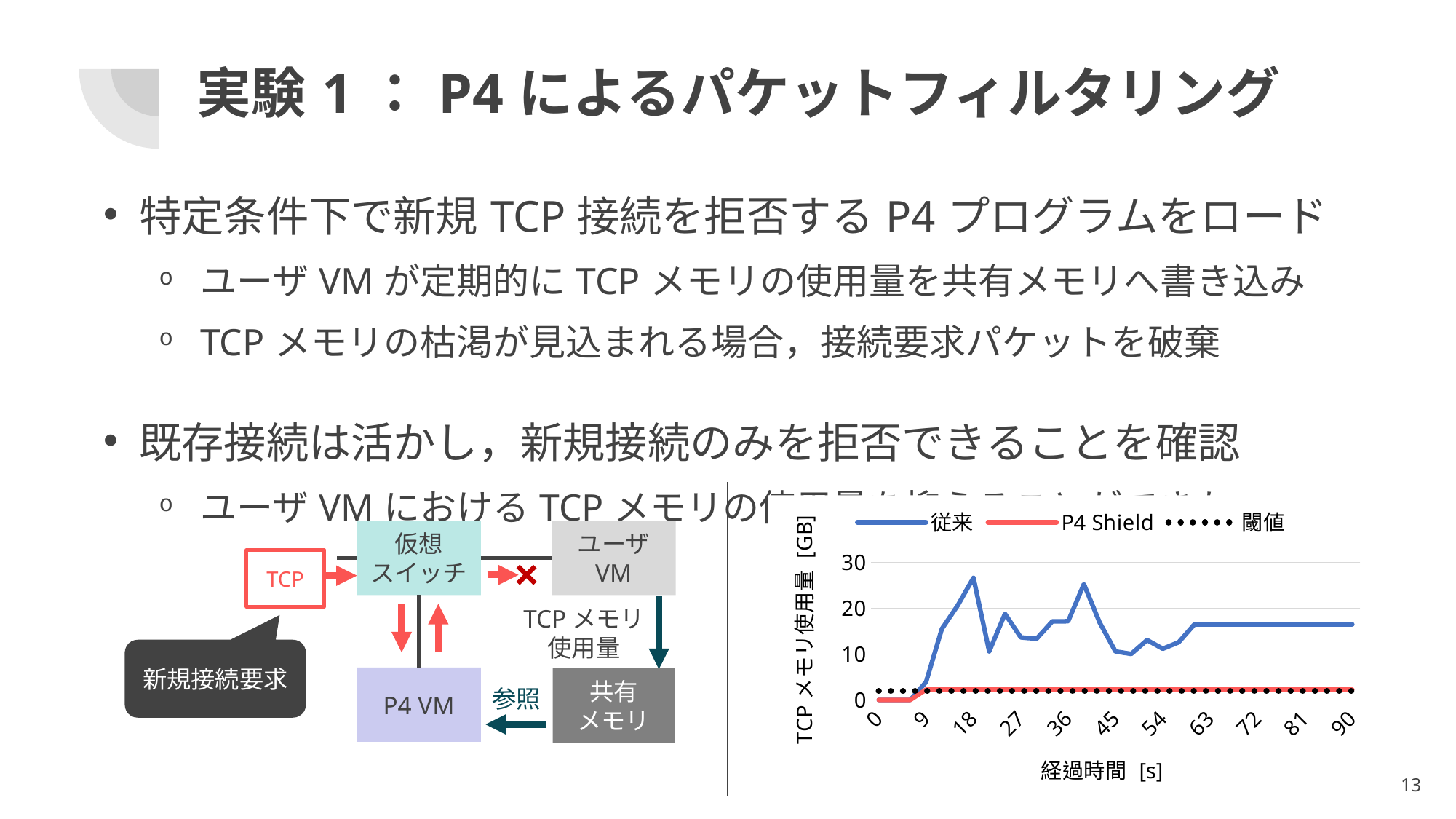
Is the value of P4 Shield at 90 s greater or less than 10? less How many series does the legend of the chart list? 3 Which series reaches the highest value on the chart? 従来 At 18 s, which series has the larger value, 従来 or P4 Shield? 従来 Is the value of 従来 at 18 s greater or less than 20? greater What is the x-axis title of the chart? 経過時間 [s] Does the 従来 series rise or fall between 9 s and 18 s? rise Is the value of 従来 at 90 s greater or less than 10? greater What are the three legend entries of the chart? 従来, P4 Shield, 閾値 How many tick labels are shown on the x axis of the chart? 11 What kind of chart is shown on the right side of the slide? line chart